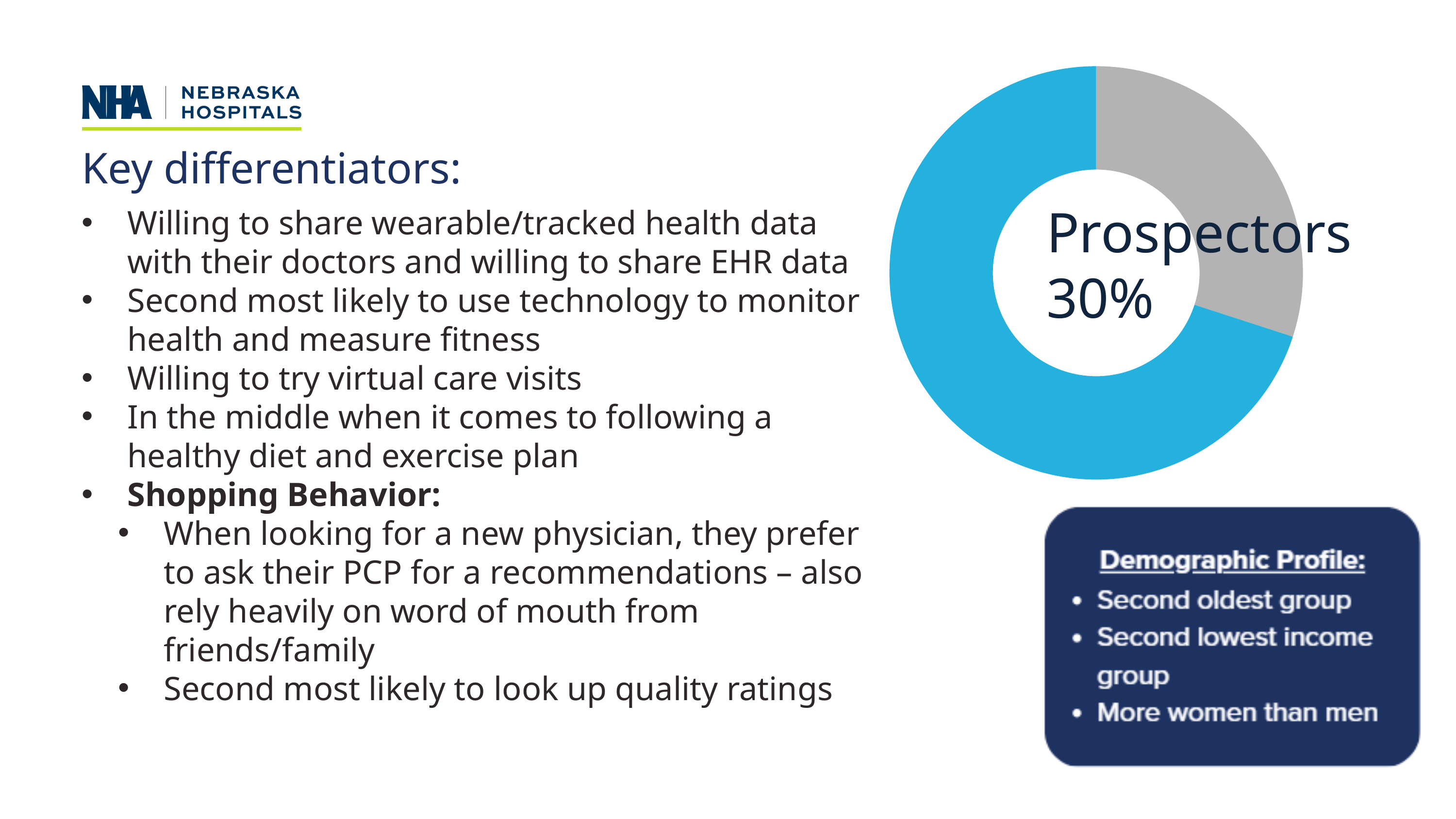
Is the Prospectors share shown in the donut chart greater or less than 50%? less What percentage is shown for Prospectors in the donut chart? 30% What kind of chart is shown on the right side of the slide? donut (pie) chart How many segments does the donut chart have? 2 What share of the donut chart does the gray segment represent? 30% What label is printed in the center of the donut chart? Prospectors What colour is the larger segment of the donut chart? blue Which segment of the donut chart is larger, the blue one or the gray one? blue